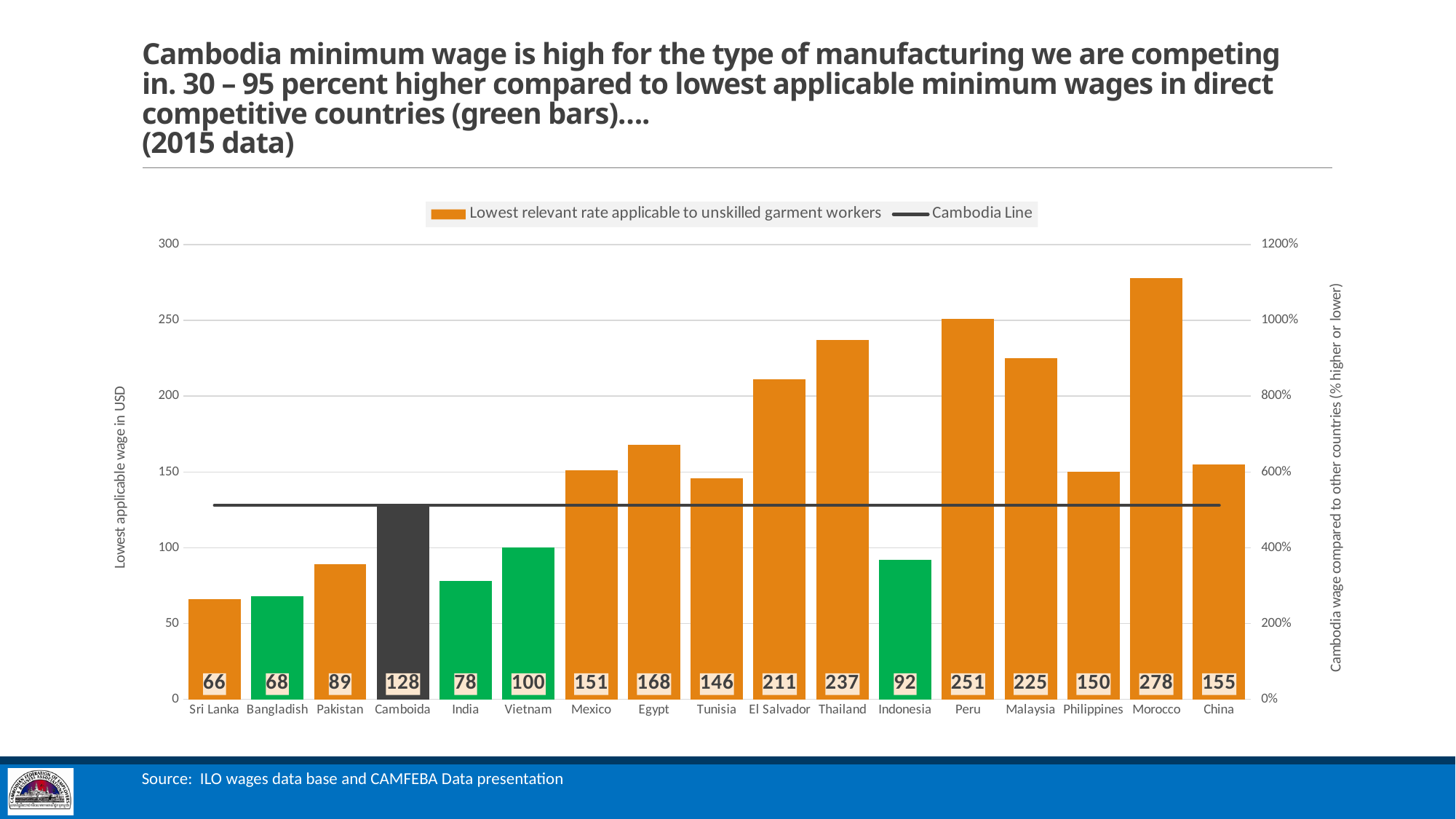
Which country has the highest lowest applicable wage in USD? Morocco How many countries are shown on the x axis of the chart? 17 What is the difference in lowest applicable wage between Morocco (278) and Peru (251)? 27 What is the lowest applicable wage in USD for Cambodia (labelled Camboida)? 128 What is the difference in lowest applicable wage between Cambodia (128) and Bangladesh (68)? 60 What is the label of the left vertical axis of the chart? Lowest applicable wage in USD What is the lowest applicable wage in USD for Vietnam? 100 Which country has the lowest lowest applicable wage in USD? Sri Lanka What kind of chart is shown on the slide? Combination bar and line chart How many entries does the chart legend list? 2 Which has a higher lowest applicable wage, Egypt or China? Egypt What is the lowest applicable wage in USD for Thailand? 237